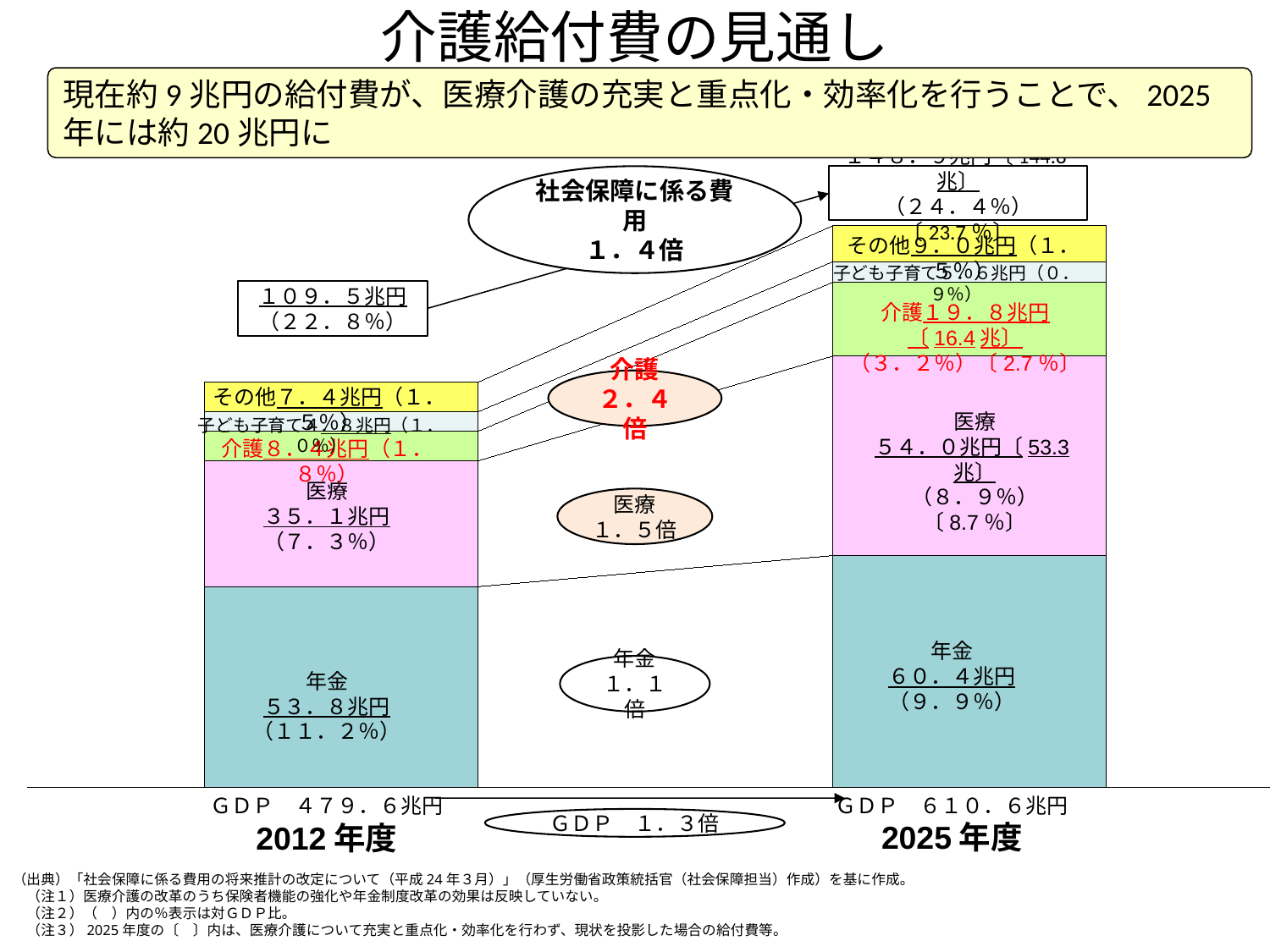
Which segment is the largest in the 2012年度 bar? 年金 What is the difference between 年金 in 2025年度 and 年金 in 2012年度? 6.6兆円 What kind of chart is shown on the slide? Stacked bar chart How many segments does each stacked bar contain? 5 Which segment is the smallest in the 2025年度 bar? 子ども子育て What is the value for 年金 in the 2012年度 bar? 53.8兆円 What is the total of the 2012年度 stacked bar? 109.5兆円 By what factor does 介護 grow from 2012年度 to 2025年度 according to the oval label? 2.4倍 What is the value for 医療 in the 2025年度 bar? 54.0兆円 What is the value for 介護 in the 2012年度 bar? 8.4兆円 Which is larger: 医療 in 2012年度 or 医療 in 2025年度? 医療 in 2025年度 What is the value for 介護 in the 2025年度 bar? 19.8兆円